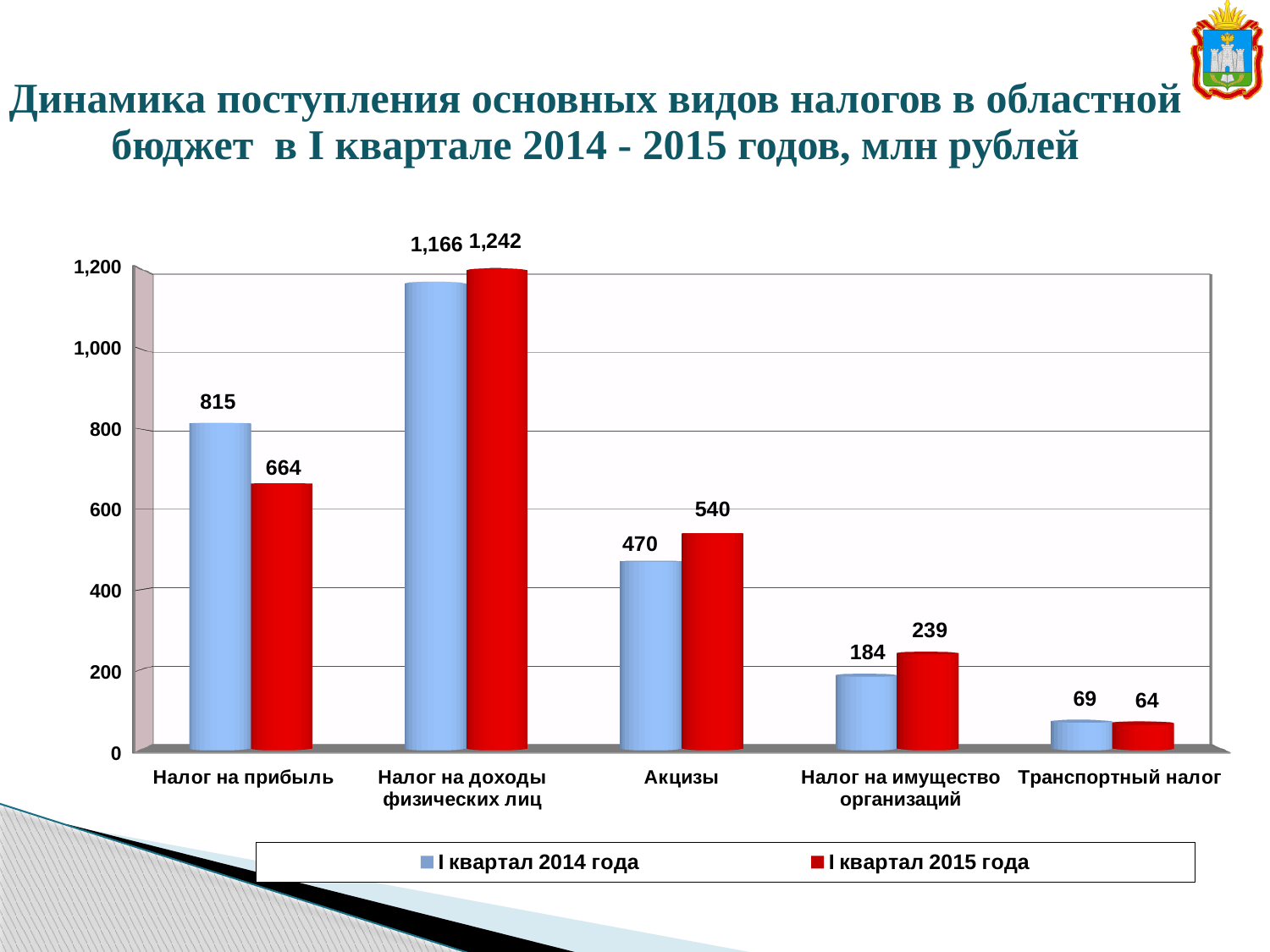
What kind of chart is shown on the slide? bar chart What is the difference between the I квартал 2015 года and I квартал 2014 года values for Налог на доходы физических лиц? 76 What is the value for Акцизы in I квартал 2015 года? 540 How many categories are shown on the x axis? 5 Which colour represents I квартал 2015 года in the chart? red Which category has the highest value in I квартал 2015 года? Налог на доходы физических лиц What is the difference between the I квартал 2014 года and I квартал 2015 года values for Налог на прибыль? 151 How many series does the legend list? 2 Which is larger for Налог на имущество организаций: the I квартал 2014 года value or the I квартал 2015 года value? I квартал 2015 года What is the value for Налог на имущество организаций in I квартал 2014 года? 184 Which category has the lowest value in I квартал 2014 года? Транспортный налог What is the value for Налог на прибыль in I квартал 2014 года? 815